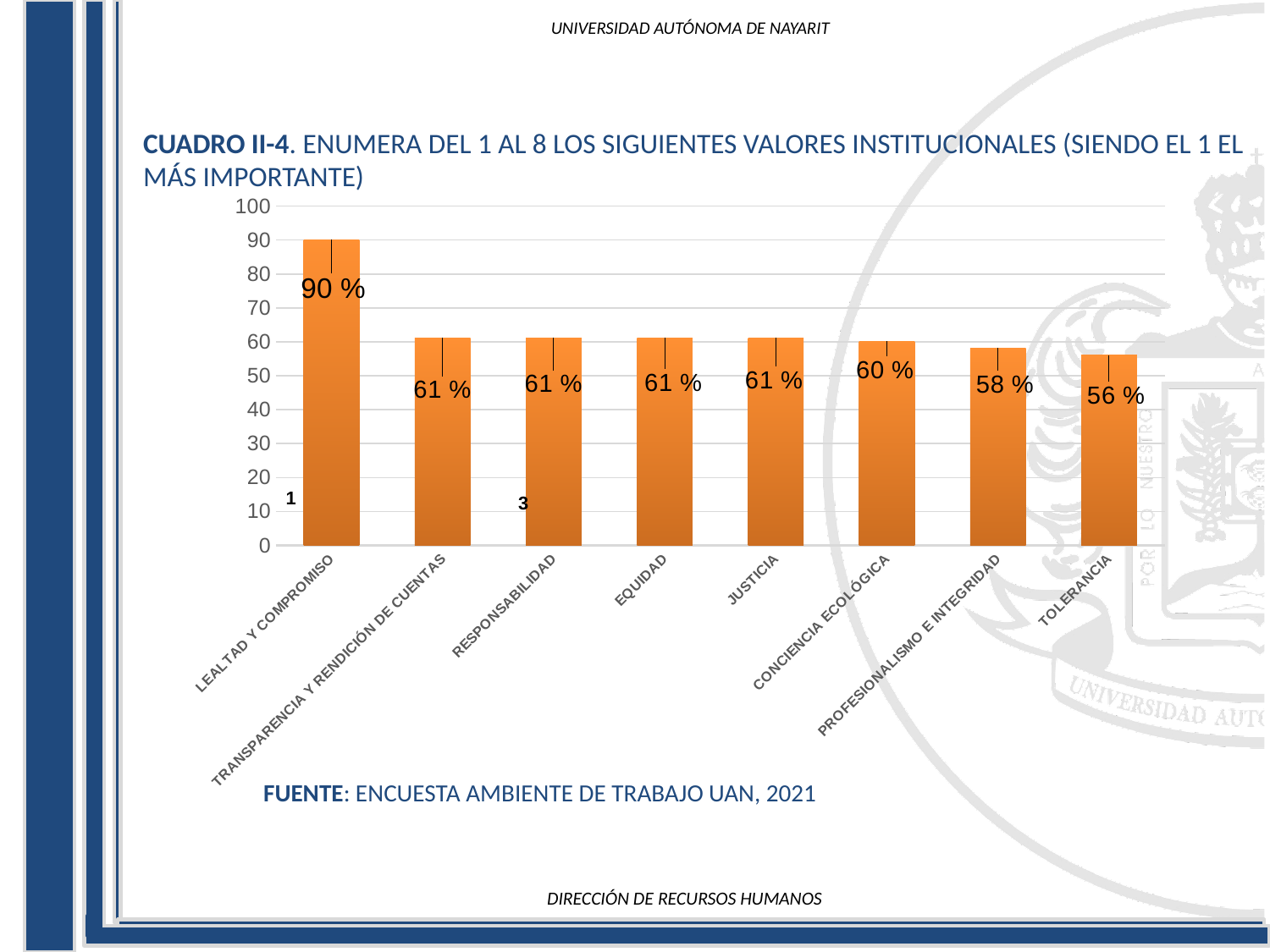
What is the value for PROFESIONALISMO E INTEGRIDAD? 58 % What is the value for TOLERANCIA? 56 % What kind of chart is shown on the slide? bar chart What source is cited below the chart? ENCUESTA AMBIENTE DE TRABAJO UAN, 2021 What is the difference between the values for LEALTAD Y COMPROMISO and TOLERANCIA? 34 % Which category has the lowest value? TOLERANCIA Which is larger, the value for CONCIENCIA ECOLÓGICA or the value for TOLERANCIA? CONCIENCIA ECOLÓGICA How many categories are shown on the x axis? 8 Which category has the highest value? LEALTAD Y COMPROMISO Is the value for LEALTAD Y COMPROMISO greater or less than 80? greater What is the value for LEALTAD Y COMPROMISO? 90 % What is the value for CONCIENCIA ECOLÓGICA? 60 %